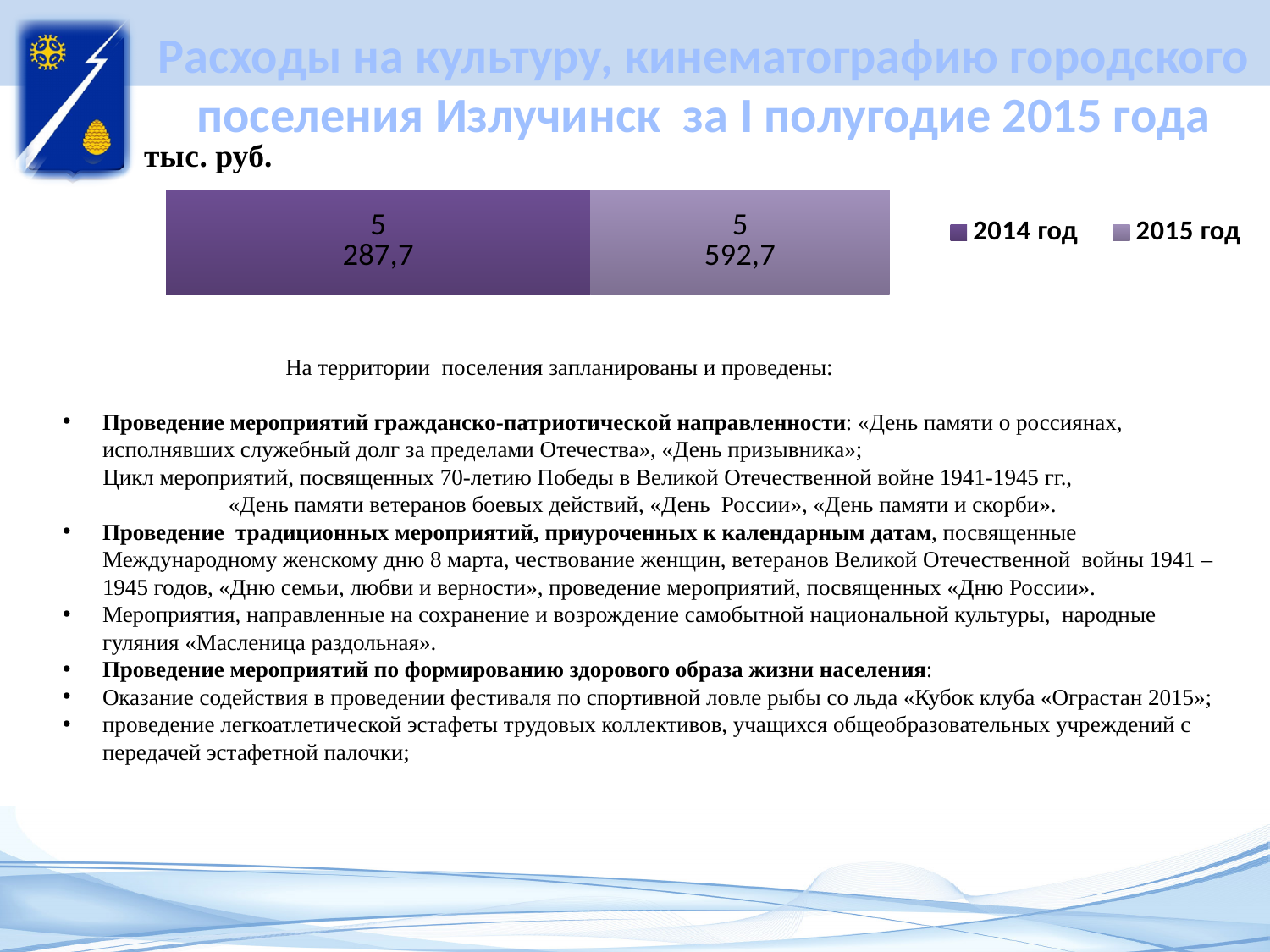
Which year has the higher value on the chart, 2014 год or 2015 год? 2015 год What is the value shown for 2014 год on the chart? 5 287,7 Which legend entry is shown in the darker purple colour? 2014 год What is the value shown for 2015 год on the chart? 5 592,7 By how much does the value for 2015 год exceed the value for 2014 год? 305 What kind of chart is shown on the slide? Stacked bar chart How many series does the legend list? 2 Which series has the highest value on the chart? 2015 год What unit is stated for the values on the chart? тыс. руб. What is the total of the two segments in the stacked bar? 10 880,4 Which series has the lowest value on the chart? 2014 год